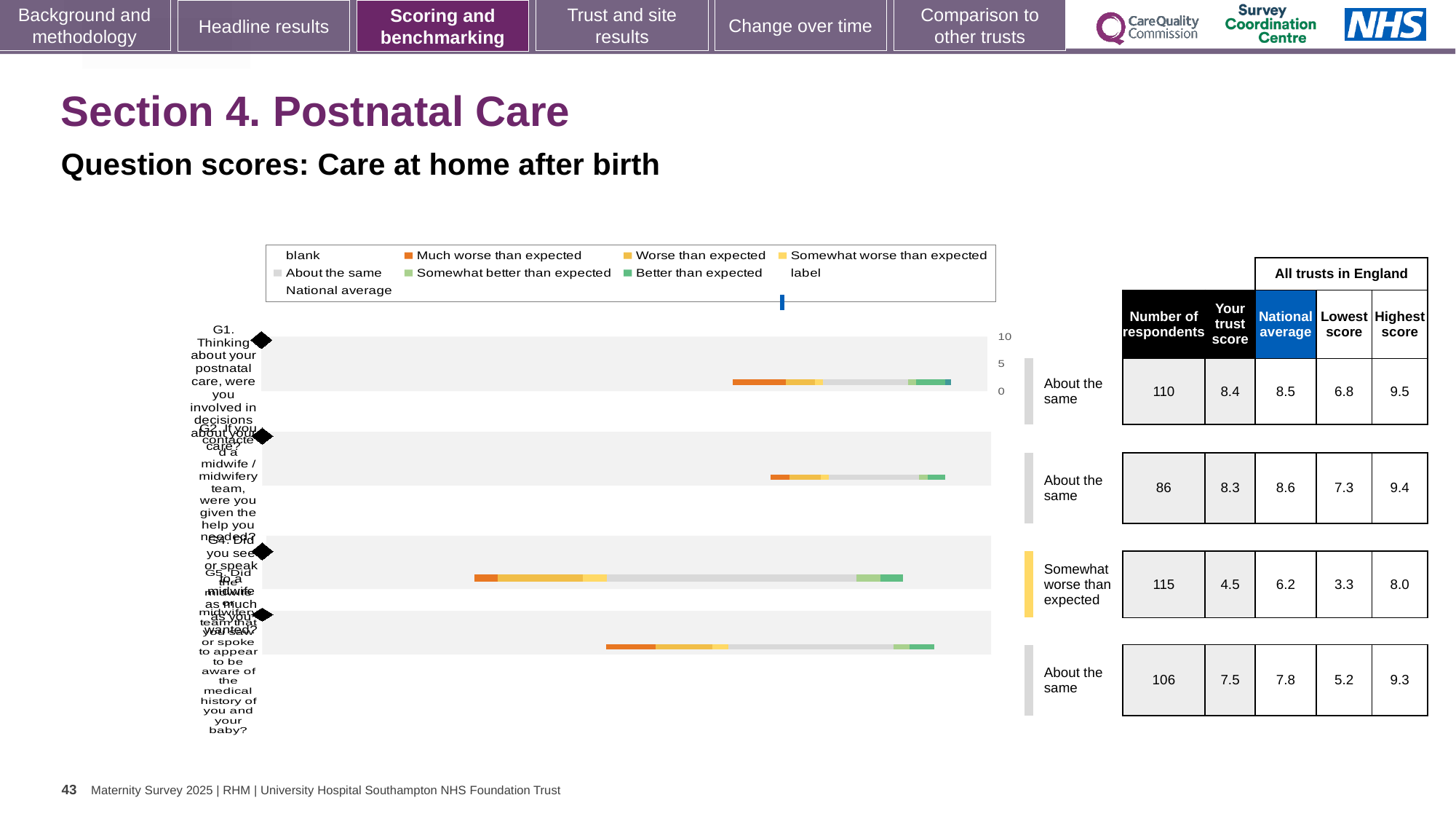
Which question is rated 'Somewhat worse than expected' in the benchmarking labels next to the chart? G4 How many question bars (G1, G2, G4, G5) are plotted in the chart? 4 What kind of chart is shown on the slide? bar chart What is the difference between the national average and the trust score for question G4? 1.7 What is the highest score across all trusts in England shown for question G5? 9.3 Which legend entry is shown in dark green in the chart legend? Better than expected What is the trust score shown for question G1 in the table beside the chart? 8.4 Which question has the lowest trust score in the table beside the chart? G4 What is the national average shown for question G4 in the table beside the chart? 6.2 How many respondents are shown for question G2 in the table beside the chart? 86 Which question has the highest trust score in the table beside the chart? G1 Which legend entry is shown in orange in the chart legend? Much worse than expected